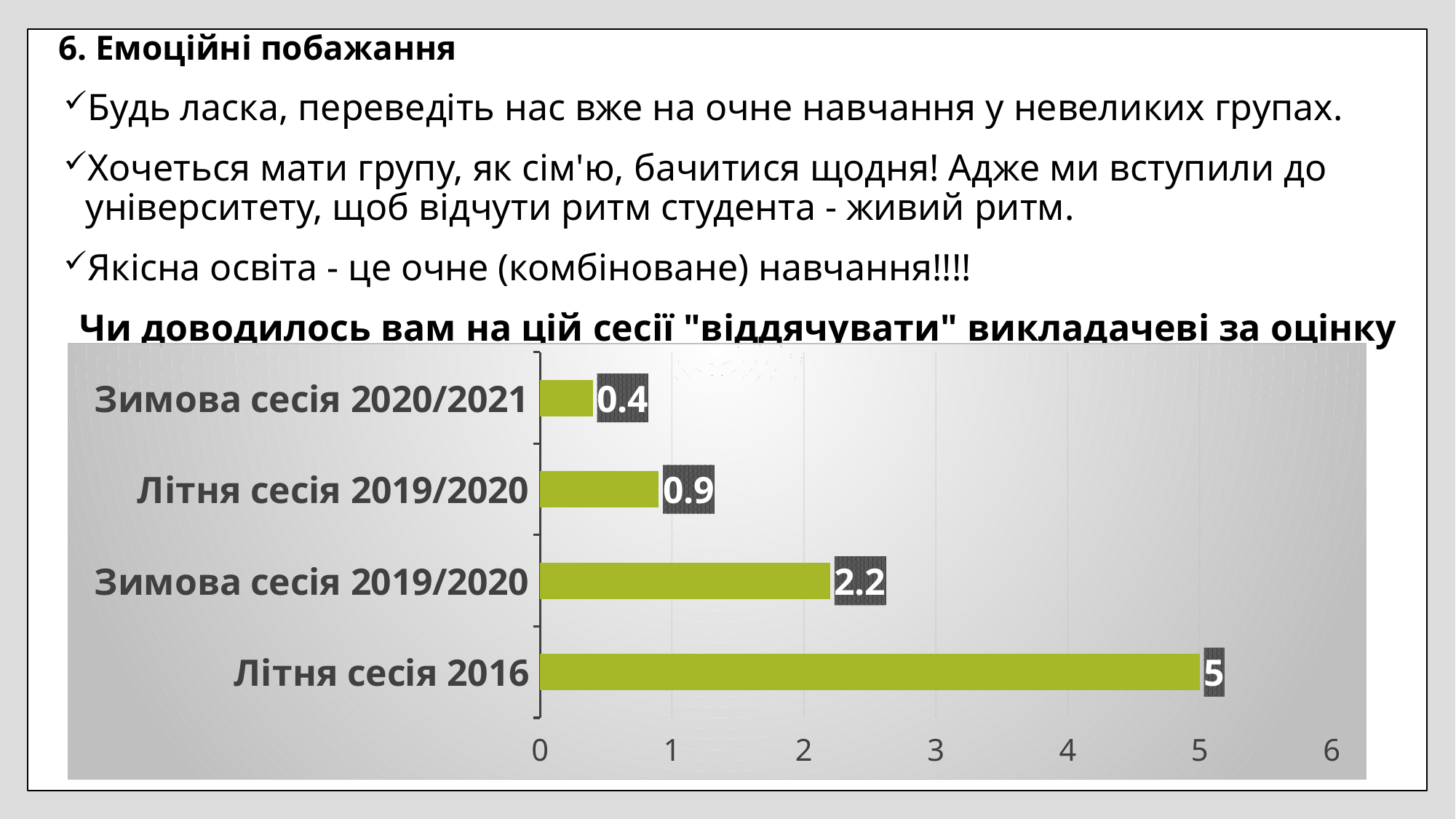
What is the value for Літня сесія 2016? 5 How many categories are shown in the chart? 4 What is the title of the chart? Чи доводилось вам на цій сесії "віддячувати" викладачеві за оцінку What kind of chart is shown on the slide? bar chart What is the value for Зимова сесія 2019/2020? 2.2 Which category has the highest value? Літня сесія 2016 What is the difference between the values for Літня сесія 2016 and Зимова сесія 2019/2020? 2.8 Which is larger, the value for Літня сесія 2019/2020 or Зимова сесія 2020/2021? Літня сесія 2019/2020 Is the value for Зимова сесія 2019/2020 greater or less than 2? greater What is the value for Зимова сесія 2020/2021? 0.4 What is the value for Літня сесія 2019/2020? 0.9 Which category has the lowest value? Зимова сесія 2020/2021